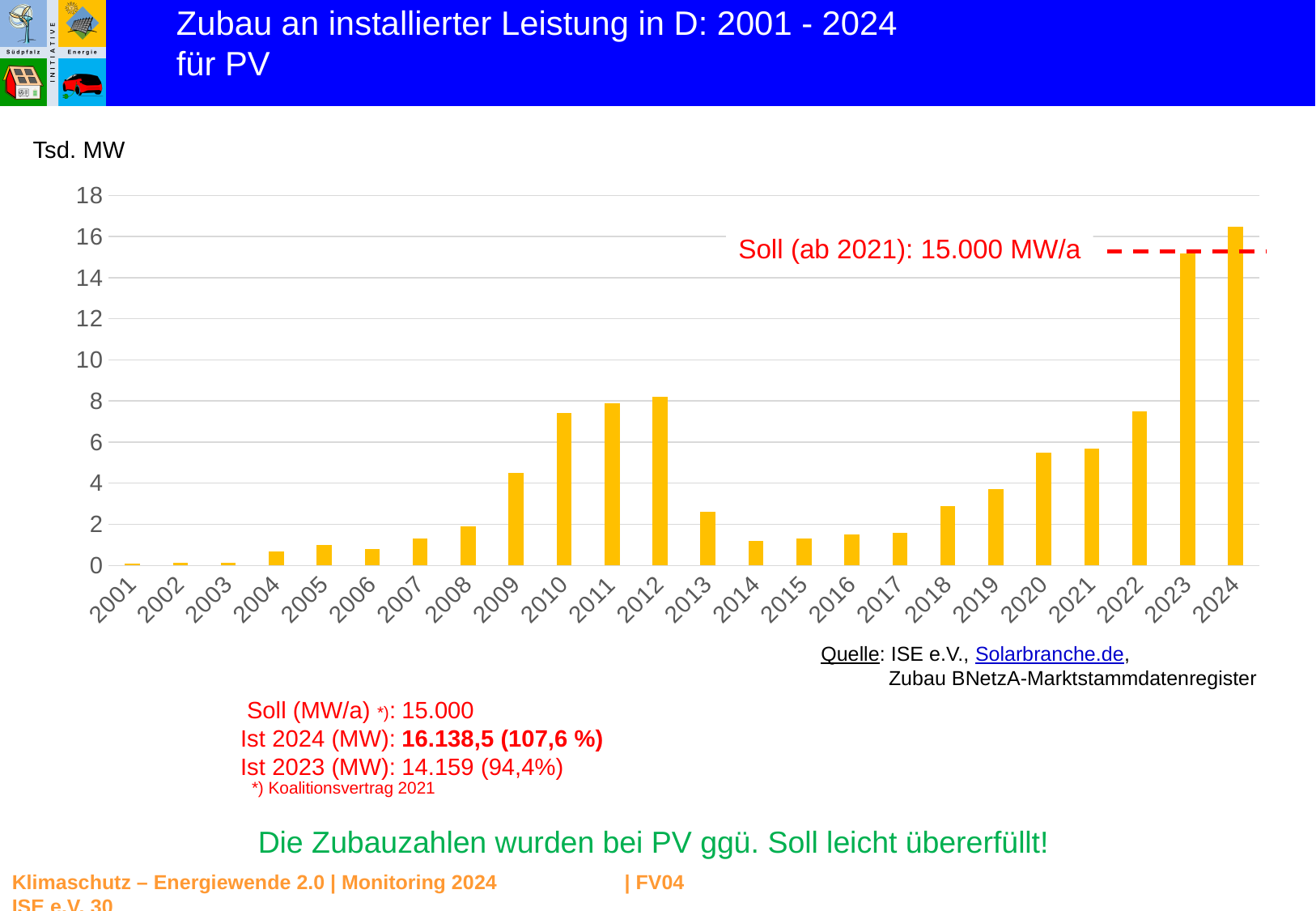
Is the value for 2012 greater or less than 6 Tsd. MW? greater Is the value for 2020 greater or less than 6 Tsd. MW? less How many years are shown on the x axis of the chart? 24 Which year has the highest PV addition in the chart? 2024 What target value does the red dashed line in the chart represent? Soll (ab 2021): 15.000 MW/a What kind of chart is shown on the slide? bar chart According to the text on the slide, what was the actual PV addition (Ist) in 2024 in MW? 16.138,5 According to the text on the slide, what was the actual PV addition (Ist) in 2023 in MW? 14.159 Which year has the larger PV addition, 2022 or 2023? 2023 Is the value for 2014 greater or less than 2 Tsd. MW? less Which year has the larger PV addition, 2012 or 2013? 2012